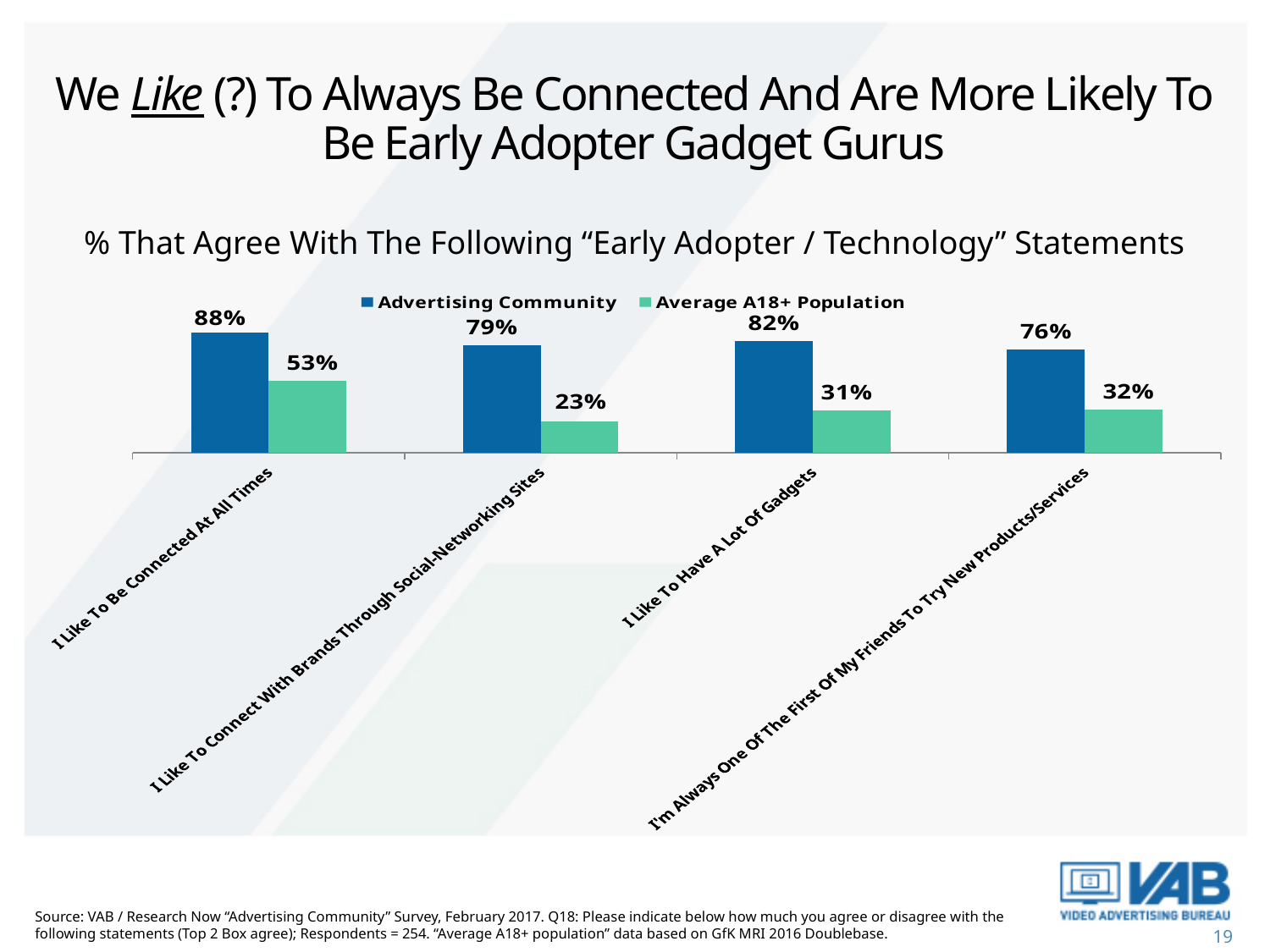
Which series is shown in dark blue in the legend? Advertising Community Which statement has the highest Advertising Community value? I Like To Be Connected At All Times What is the Advertising Community value for "I'm Always One Of The First Of My Friends To Try New Products/Services"? 76% What percentage of the Average A18+ Population agrees with "I Like To Connect With Brands Through Social-Networking Sites"? 23% How many statements are shown on the x axis of the chart? 4 What kind of chart is shown on the slide? Bar chart Which is larger for "I Like To Be Connected At All Times": the Advertising Community value or the Average A18+ Population value? Advertising Community What is the Average A18+ Population value for "I'm Always One Of The First Of My Friends To Try New Products/Services"? 32% How many series does the legend list? 2 Which statement has the lowest Average A18+ Population value? I Like To Connect With Brands Through Social-Networking Sites What is the difference between the Advertising Community and Average A18+ Population values for "I Like To Have A Lot Of Gadgets"? 51 percentage points What percentage of the Advertising Community agrees with "I Like To Be Connected At All Times"? 88%